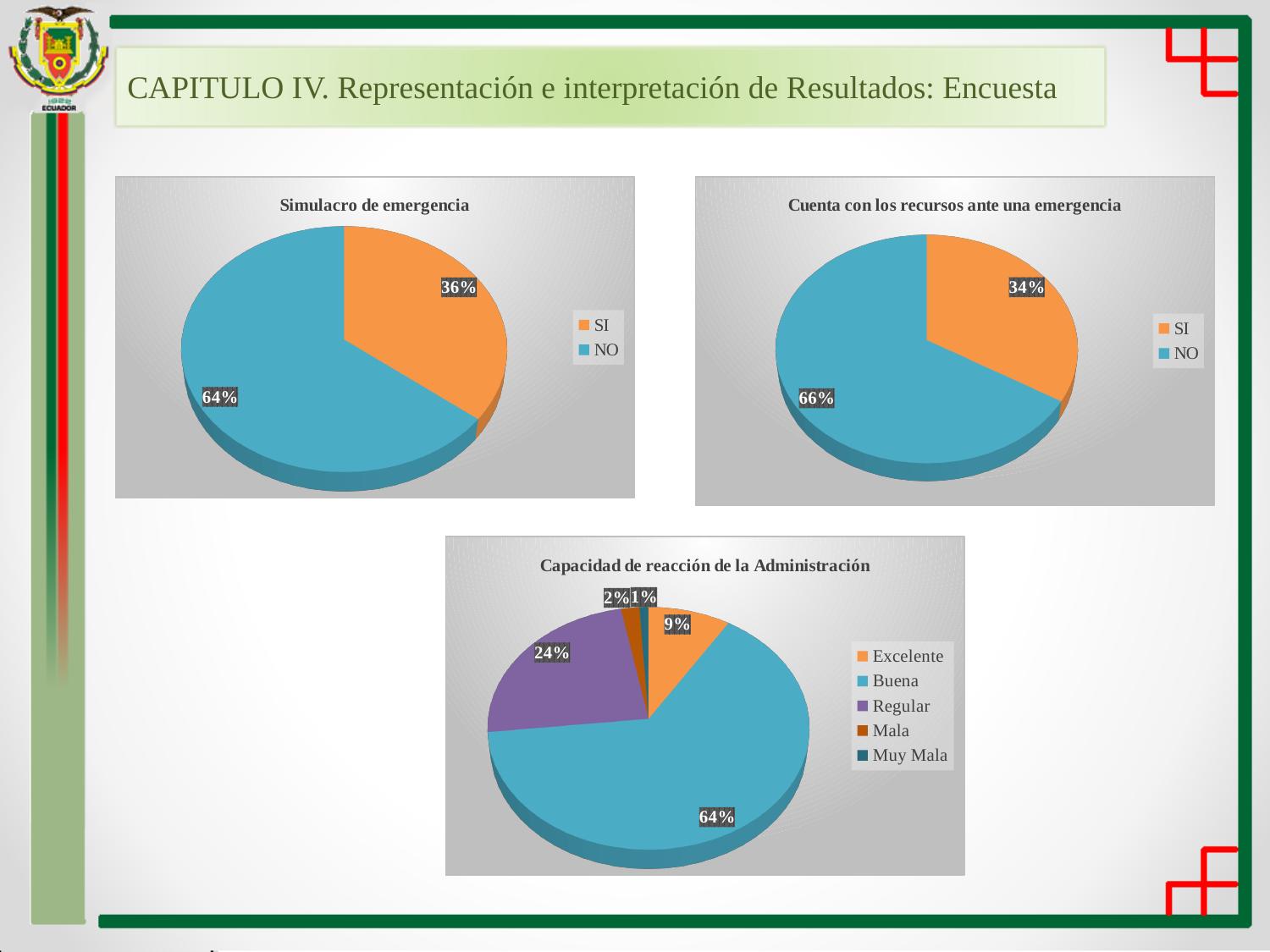
In the 'Cuenta con los recursos ante una emergencia' chart, what share of responses is SI? 34% In the 'Cuenta con los recursos ante una emergencia' chart, which is larger, SI or NO? NO In the 'Simulacro de emergencia' chart, what share of responses is NO? 64% What kind of chart is 'Capacidad de reacción de la Administración'? Pie chart In the 'Simulacro de emergencia' chart, what is the difference between the NO and SI shares? 28% In the 'Cuenta con los recursos ante una emergencia' chart, what share of responses is NO? 66% In the 'Simulacro de emergencia' chart, what share of responses is SI? 36% In the 'Capacidad de reacción de la Administración' chart, which category has the largest share? Buena In the 'Capacidad de reacción de la Administración' chart, what share is Excelente? 9% In the 'Capacidad de reacción de la Administración' chart, which category has the smallest share? Muy Mala In the 'Capacidad de reacción de la Administración' chart, what share is Regular? 24% How many categories does the legend of the 'Capacidad de reacción de la Administración' chart list? 5